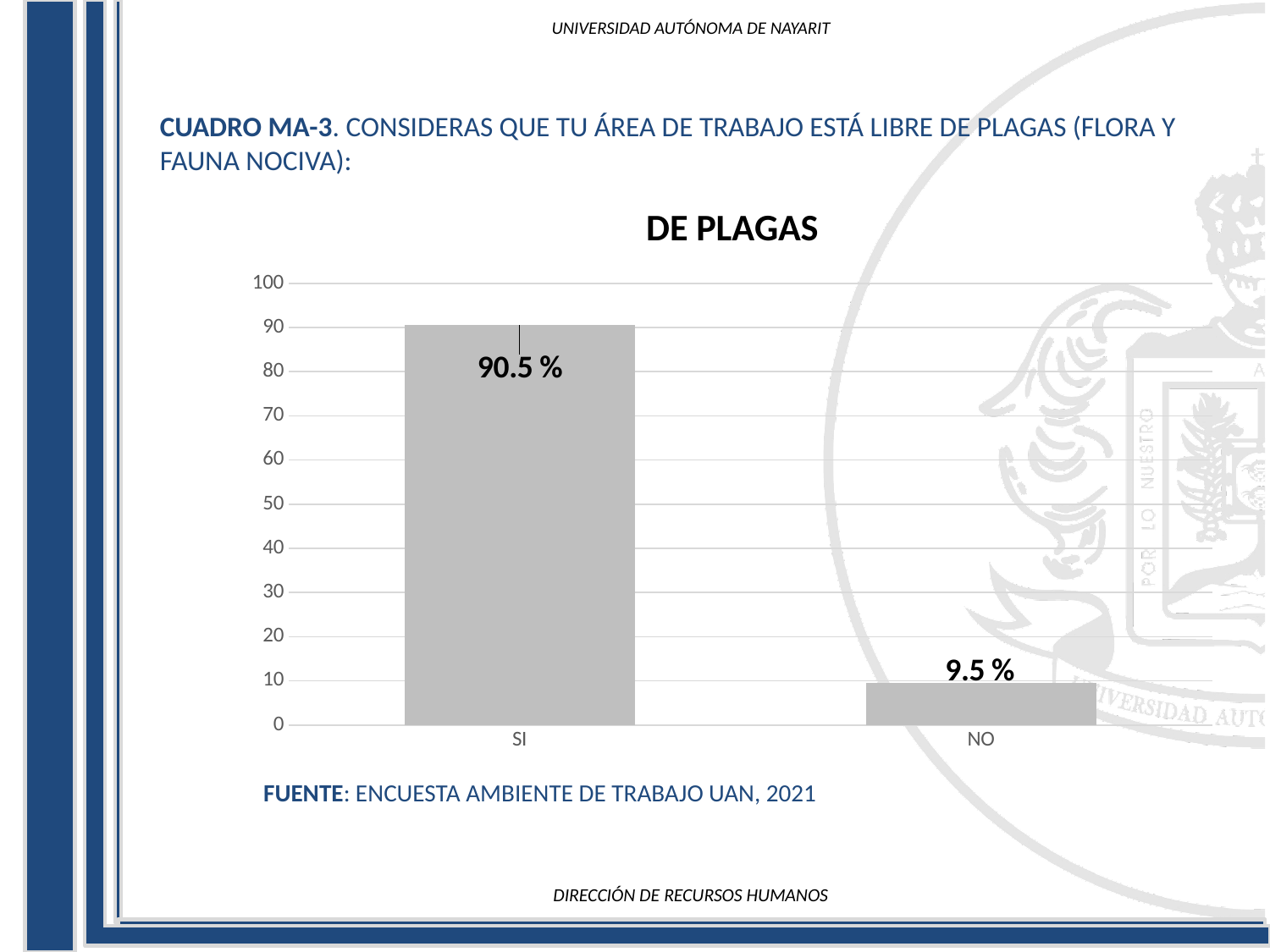
What kind of chart is shown on the slide? bar chart What is the difference between the values for SI and NO? 81 % Which is larger, the value for SI or the value for NO? SI How many categories are shown on the x axis? 2 Is the value for NO greater or less than 20? less What is the title of the chart? DE PLAGAS What is the value for NO? 9.5 % Is the value for SI greater or less than 80? greater Which category has the lowest value? NO What is the highest value shown on the y axis? 100 Which category has the highest value? SI What is the value for SI? 90.5 %